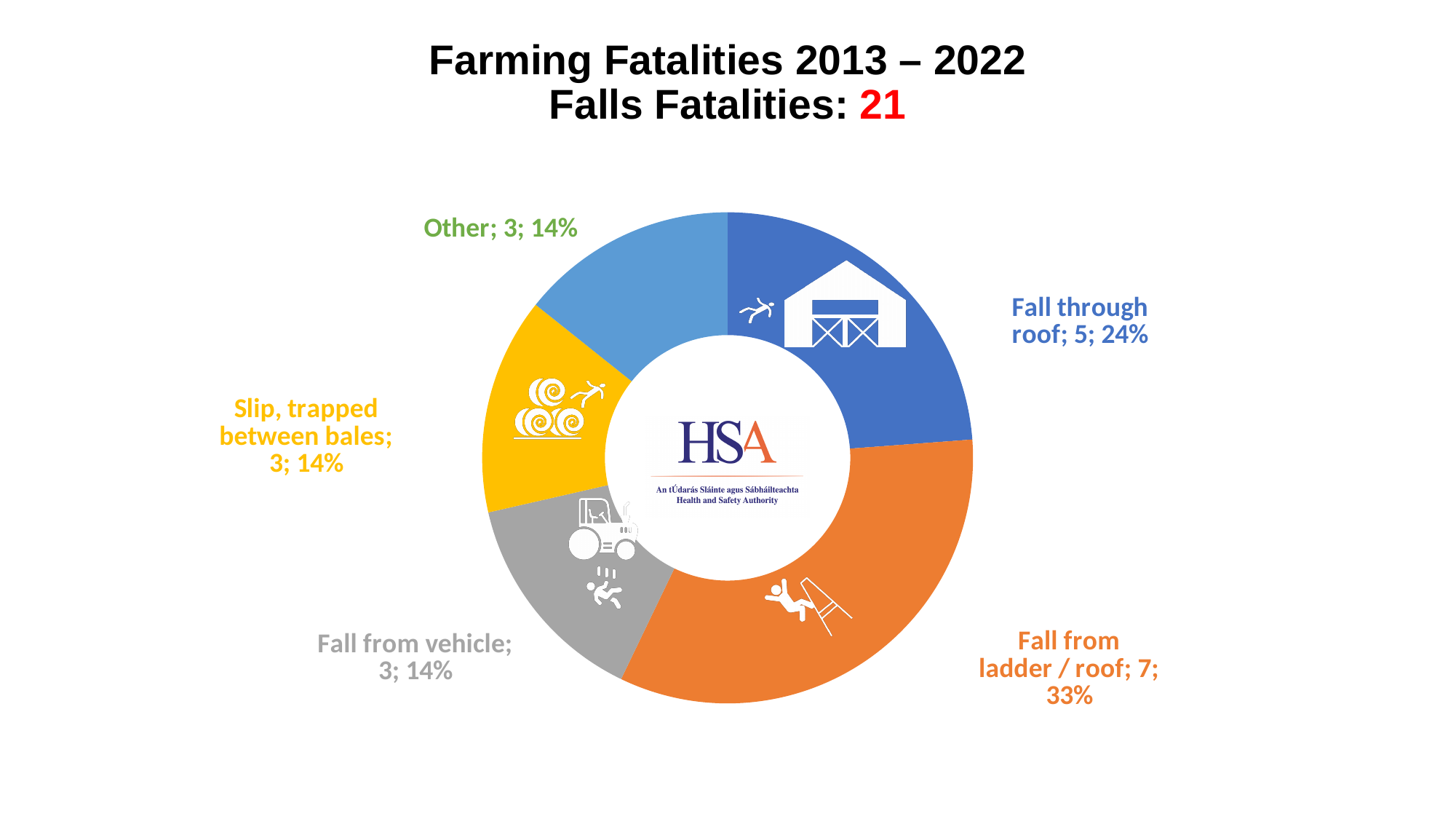
What is the total number of falls fatalities shown in the title? 21 What colour is the 'Slip, trapped between bales' slice? Yellow What kind of chart is shown on the slide? Pie chart (doughnut) What percentage share does 'Fall through roof' have? 24% What is the title of the chart? Farming Fatalities 2013 – 2022 Falls Fatalities: 21 How many fatalities are attributed to falls from ladder / roof? 7 How many fatalities are attributed to 'Fall from vehicle'? 3 Which is larger: the number of fatalities from 'Fall through roof' or from 'Slip, trapped between bales'? Fall through roof How many categories are shown in the chart? 5 What is the difference in fatalities between 'Fall from ladder / roof' and 'Fall through roof'? 2 Which category has the largest number of fatalities? Fall from ladder / roof What percentage share does 'Other' have? 14%